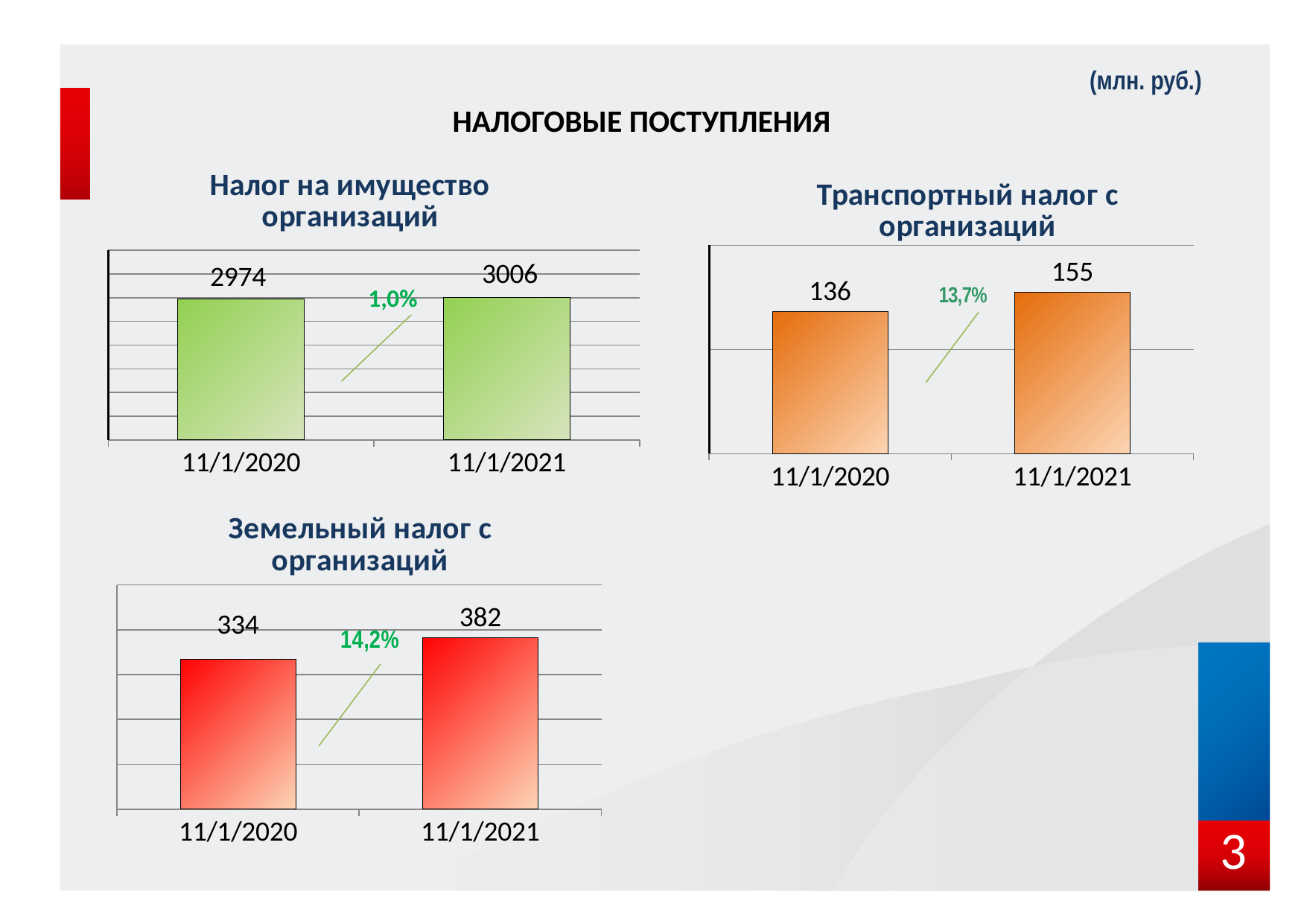
In the chart titled 'Транспортный налог с организаций', what is the value for 11/1/2021? 155 In the chart titled 'Земельный налог с организаций', what is the difference between the 11/1/2021 and 11/1/2020 values? 48 In the chart titled 'Транспортный налог с организаций', what is the value for 11/1/2020? 136 What kind of chart is the chart titled 'Транспортный налог с организаций'? bar chart In the chart titled 'Транспортный налог с организаций', what is the difference between the 11/1/2021 and 11/1/2020 values? 19 In the chart titled 'Налог на имущество организаций', what is the value for 11/1/2020? 2974 In the chart titled 'Земельный налог с организаций', what is the value for 11/1/2021? 382 In the chart titled 'Земельный налог с организаций', what percentage change is shown between the two bars? 14,2% In the chart titled 'Налог на имущество организаций', what is the value for 11/1/2021? 3006 In the chart titled 'Земельный налог с организаций', what is the value for 11/1/2020? 334 In the chart titled 'Земельный налог с организаций', which date has the higher value? 11/1/2021 In the chart titled 'Налог на имущество организаций', what is the difference between the 11/1/2021 and 11/1/2020 values? 32